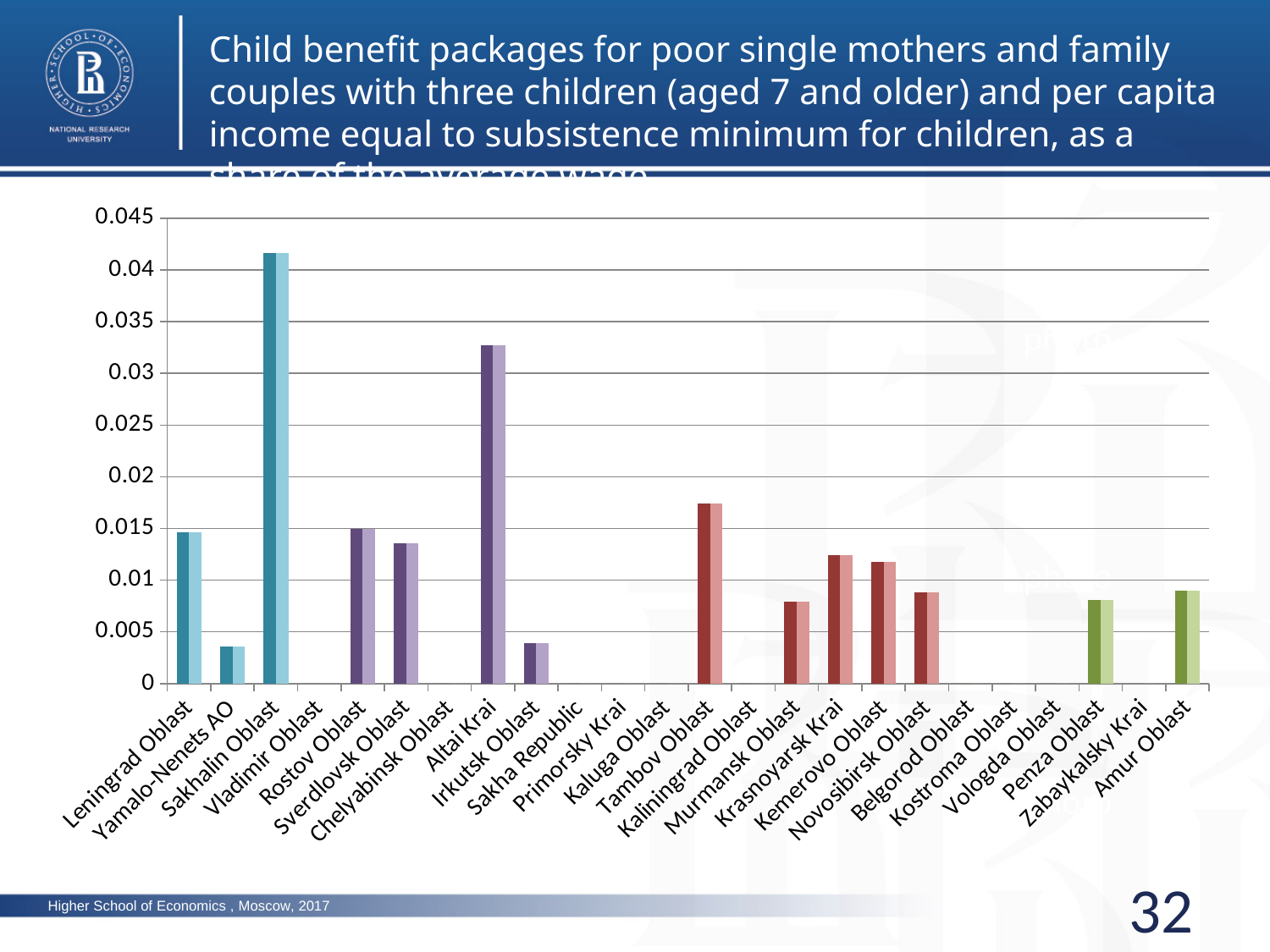
Is the value for Murmansk Oblast greater or less than 0.01? less Is the value for Altai Krai greater or less than 0.03? greater Is the value for Tambov Oblast greater or less than 0.015? greater Which is larger, the value for Irkutsk Oblast or the value for Krasnoyarsk Krai? Krasnoyarsk Krai Which is larger, the value for Tambov Oblast or the value for Novosibirsk Oblast? Tambov Oblast How many regions are listed along the x axis of the chart? 24 What kind of chart is shown on the slide? bar chart Which region has the highest value in the chart? Sakhalin Oblast What is the highest value shown on the y axis of the chart? 0.045 Which is larger, the value for Sakhalin Oblast or the value for Altai Krai? Sakhalin Oblast